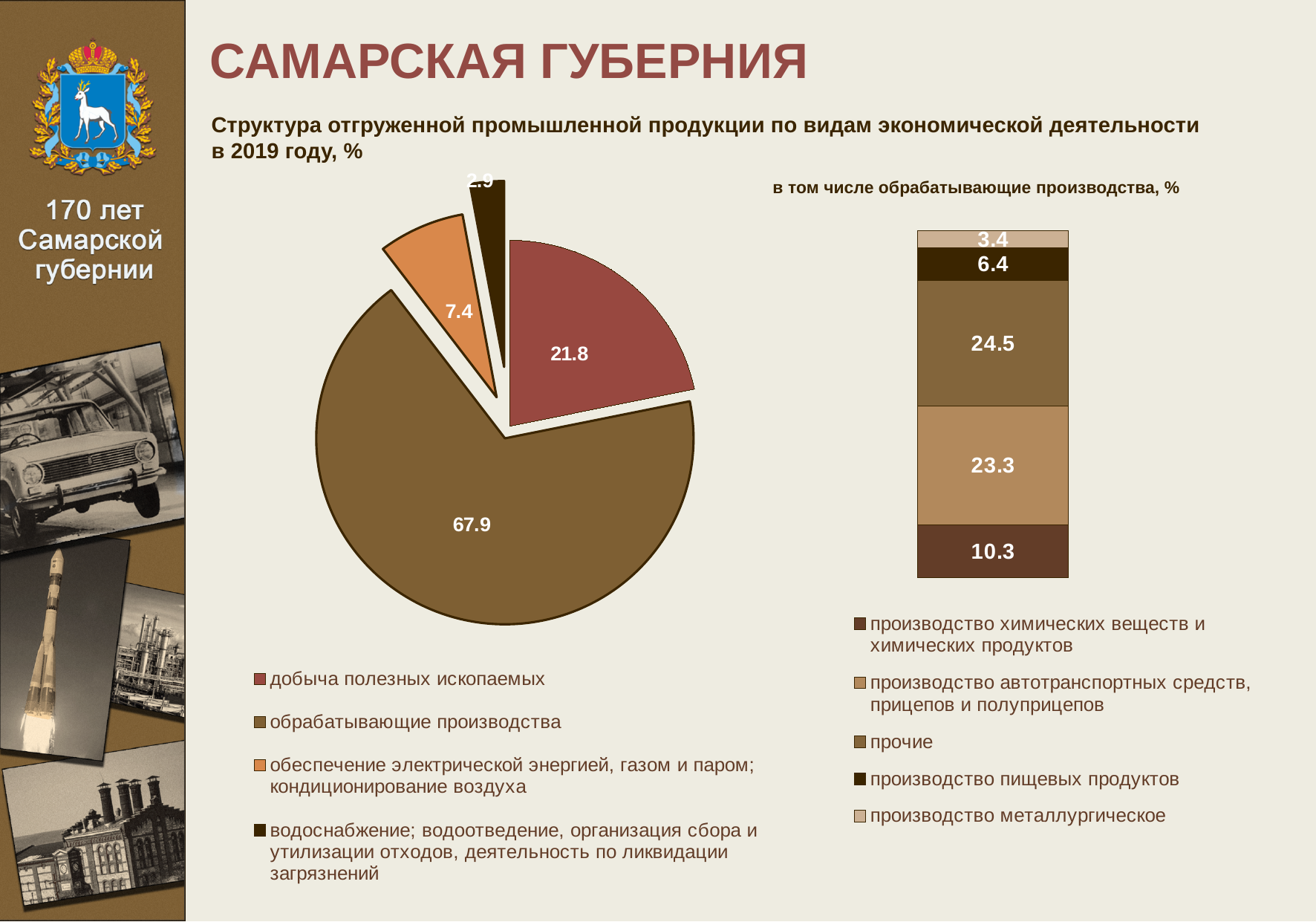
What kind of chart is the chart on the right titled 'в том числе обрабатывающие производства, %'? stacked bar chart In the stacked bar chart on the right, what is the total of all segments in the bar? 67.9 In the stacked bar chart on the right, which segment has the smallest value? производство металлургическое In the pie chart on the left, what share is shown for обрабатывающие производства? 67.9 In the stacked bar chart on the right, what value is shown for производство химических веществ и химических продуктов? 10.3 In the pie chart on the left, how many categories does the legend list? 4 In the stacked bar chart on the right, which is larger: производство пищевых продуктов or производство металлургическое? производство пищевых продуктов In the pie chart on the left, which category has the largest slice? обрабатывающие производства In the pie chart on the left, what share is shown for обеспечение электрической энергией, газом и паром; кондиционирование воздуха? 7.4 In the pie chart on the left, what is the difference between the shares for обрабатывающие производства and добыча полезных ископаемых? 46.1 In the stacked bar chart on the right, what value is shown for производство автотранспортных средств, прицепов и полуприцепов? 23.3 In the pie chart on the left, what share is shown for добыча полезных ископаемых? 21.8